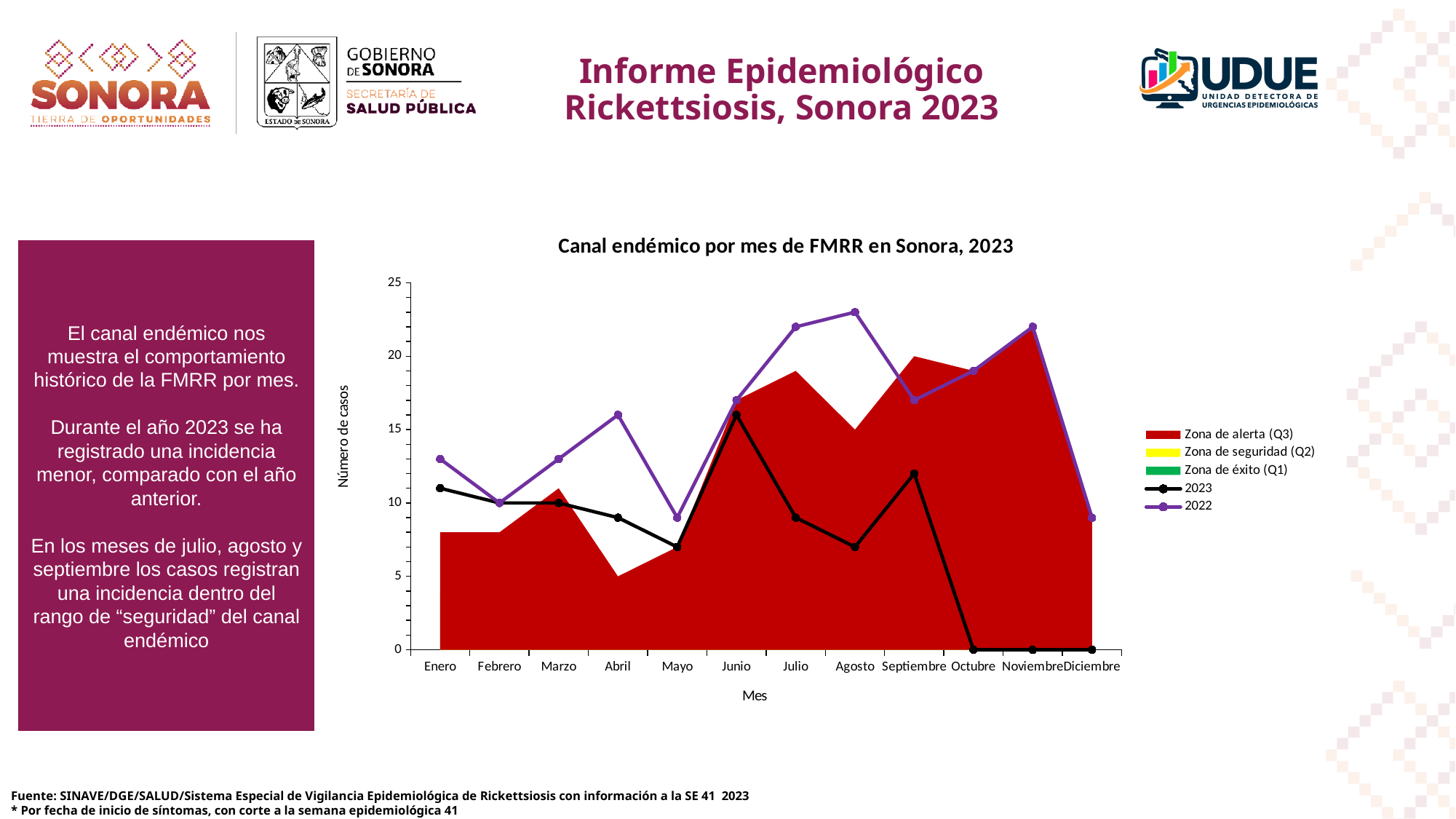
In which month does the 2023 line reach its highest value? Junio What is the value of the 2023 line in Octubre? 0 How many months are shown on the x axis of the chart? 12 Does the 2023 line rise or fall from Septiembre to Octubre? fall What colour is the 'Zona de alerta (Q3)' area in the chart? red Is the value of the 2022 line in Julio greater or less than 20? greater In Abril, which series has the higher value, 2022 or 2023? 2022 Is the value of the 2023 line in Mayo greater or less than 10? less What kind of chart is used to show the 2022 and 2023 series? line chart How many entries does the chart legend list? 5 What is the title of the chart? Canal endémico por mes de FMRR en Sonora, 2023 Is the value of the 2022 line in Agosto greater or less than 20? greater